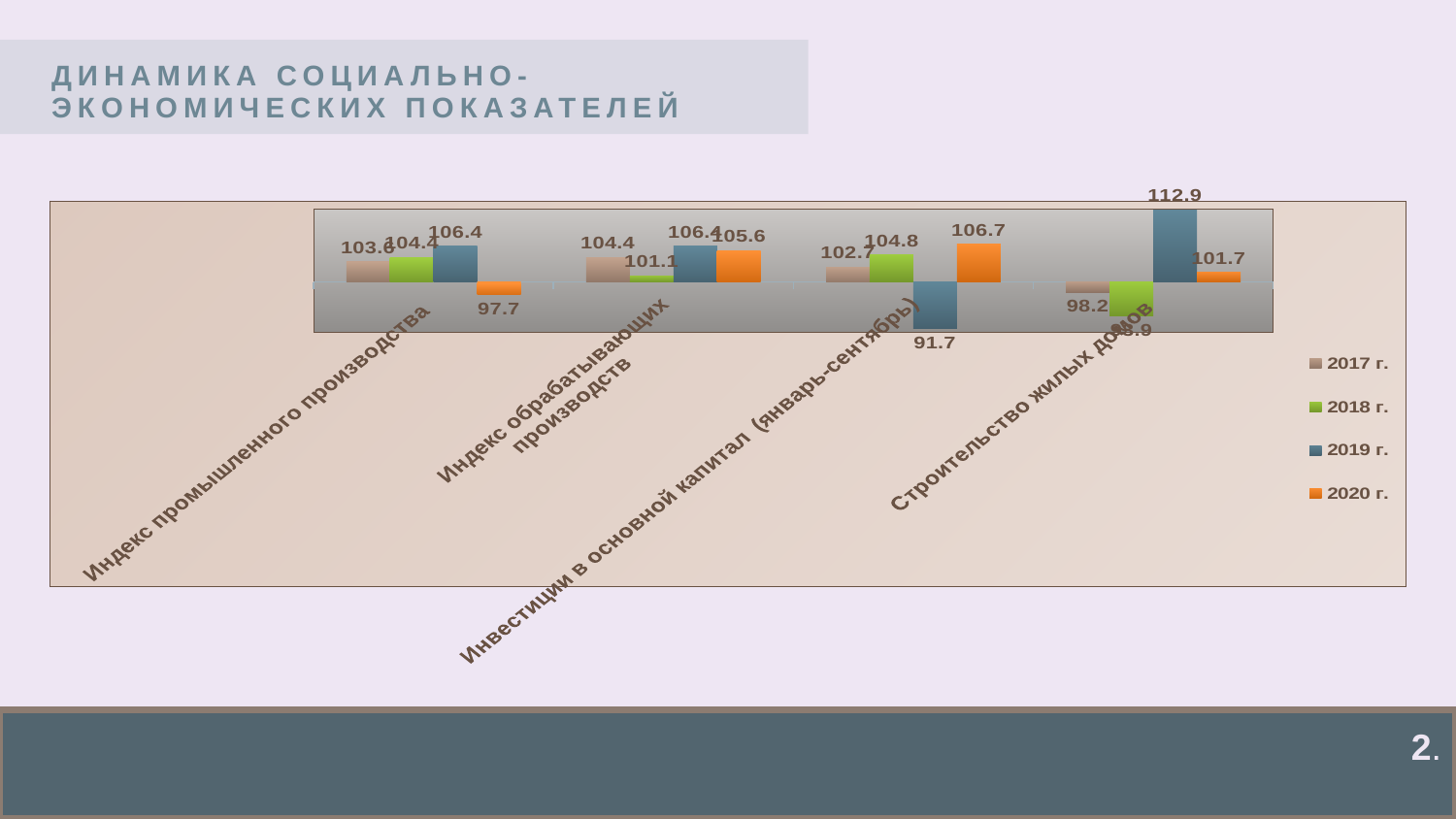
What is the difference between the 2019 г. and 2020 г. values for Индекс промышленного производства? 8.7 Which series is shown in orange in the legend? 2020 г. What is the value for 2019 г. for Инвестиции в основной капитал (январь-сентябрь)? 91.7 Which category has the highest value for 2019 г.? Строительство жилых домов What is the value for 2019 г. for Строительство жилых домов? 112.9 What kind of chart is shown on the slide? bar chart What is the value for 2020 г. for Индекс промышленного производства? 97.7 Which category has the lowest value for 2020 г.? Индекс промышленного производства How many categories are shown on the x axis? 4 How many series does the legend list? 4 For Инвестиции в основной капитал (январь-сентябрь), which is larger: the 2018 г. value or the 2020 г. value? 2020 г. What is the value for 2018 г. for Индекс обрабатывающих производств? 101.1